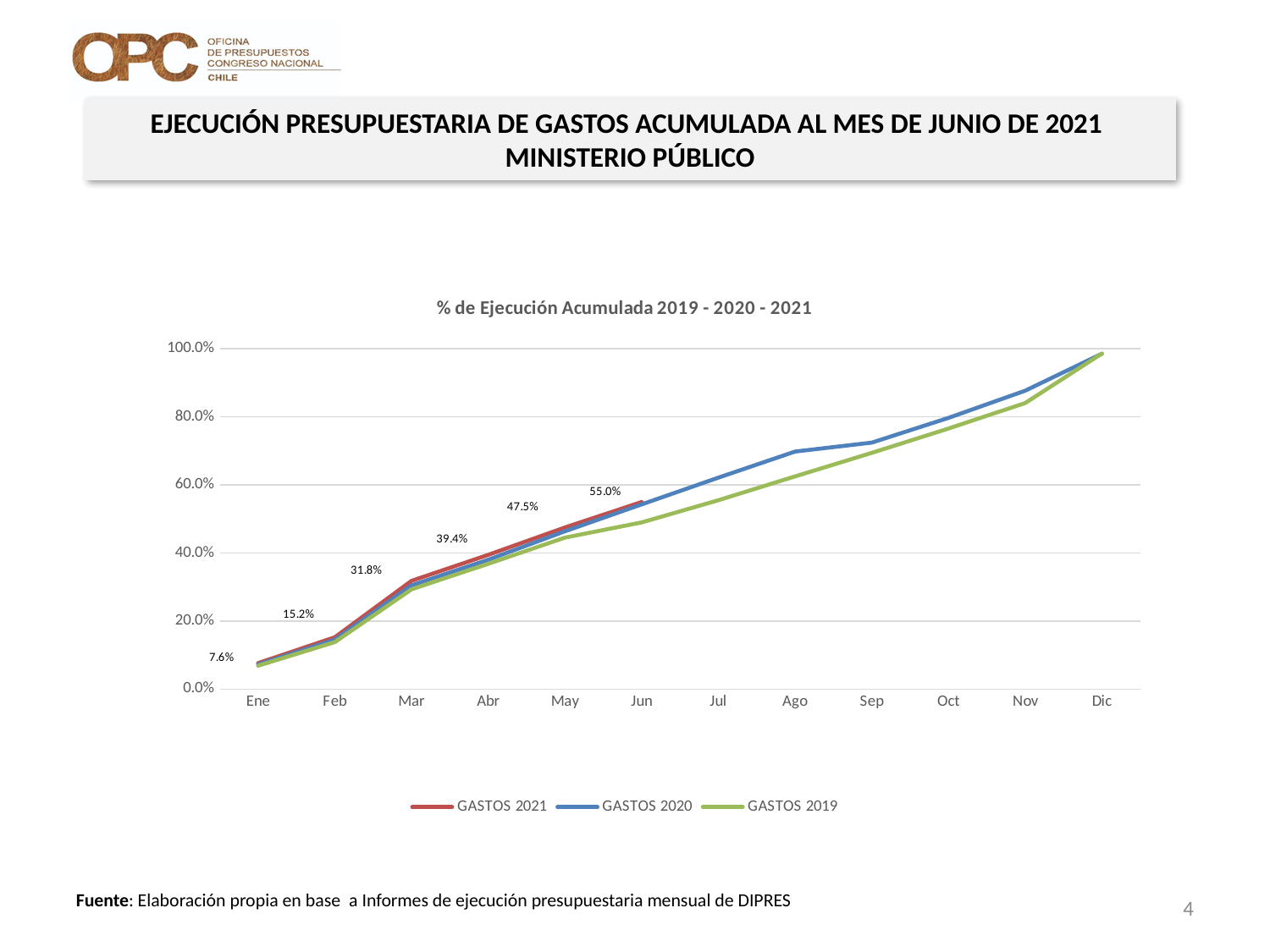
Do the GASTOS 2020 values rise or fall from Ene to Dic? rise What is the value for GASTOS 2021 in Abr? 39.4% What is the title of the chart? % de Ejecución Acumulada 2019 - 2020 - 2021 What is the difference between the GASTOS 2021 values for Jun and May? 7.5% What is the value for GASTOS 2021 in Mar? 31.8% What is the value for GASTOS 2021 in Jun? 55.0% How many months are shown on the x axis? 12 How many series does the legend list? 3 Is the value for GASTOS 2020 in Ago greater or less than 60.0%? greater Is the value for GASTOS 2019 in Sep greater or less than 80.0%? less What kind of chart is shown on the slide? line chart What is the difference between the GASTOS 2021 values for Feb and Ene? 7.6%